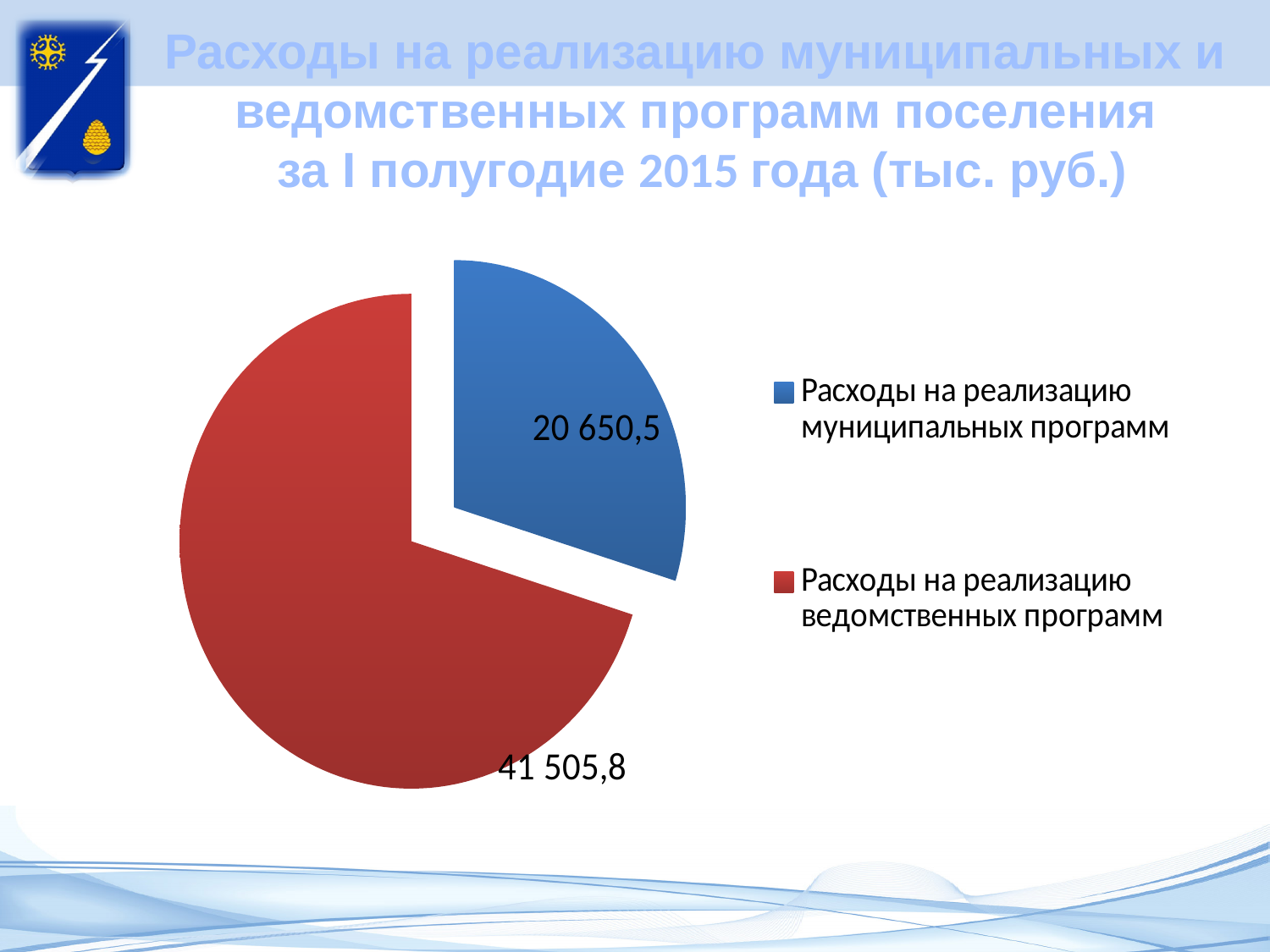
На сколько расходы на реализацию ведомственных программ превышают расходы на реализацию муниципальных программ? 20 855,3 Что больше: расходы на реализацию муниципальных программ или расходы на реализацию ведомственных программ? Расходы на реализацию ведомственных программ Какова общая сумма расходов по двум категориям диаграммы? 62 156,3 Какая категория имеет наибольшее значение? Расходы на реализацию ведомственных программ Сколько секторов на круговой диаграмме? 2 Каковы расходы на реализацию ведомственных программ? 41 505,8 Какой тип диаграммы показан на слайде? Круговая диаграмма Каким цветом обозначены расходы на реализацию муниципальных программ? Синим Сколько элементов перечислено в легенде диаграммы? 2 Какая категория имеет наименьшее значение? Расходы на реализацию муниципальных программ Каковы расходы на реализацию муниципальных программ? 20 650,5